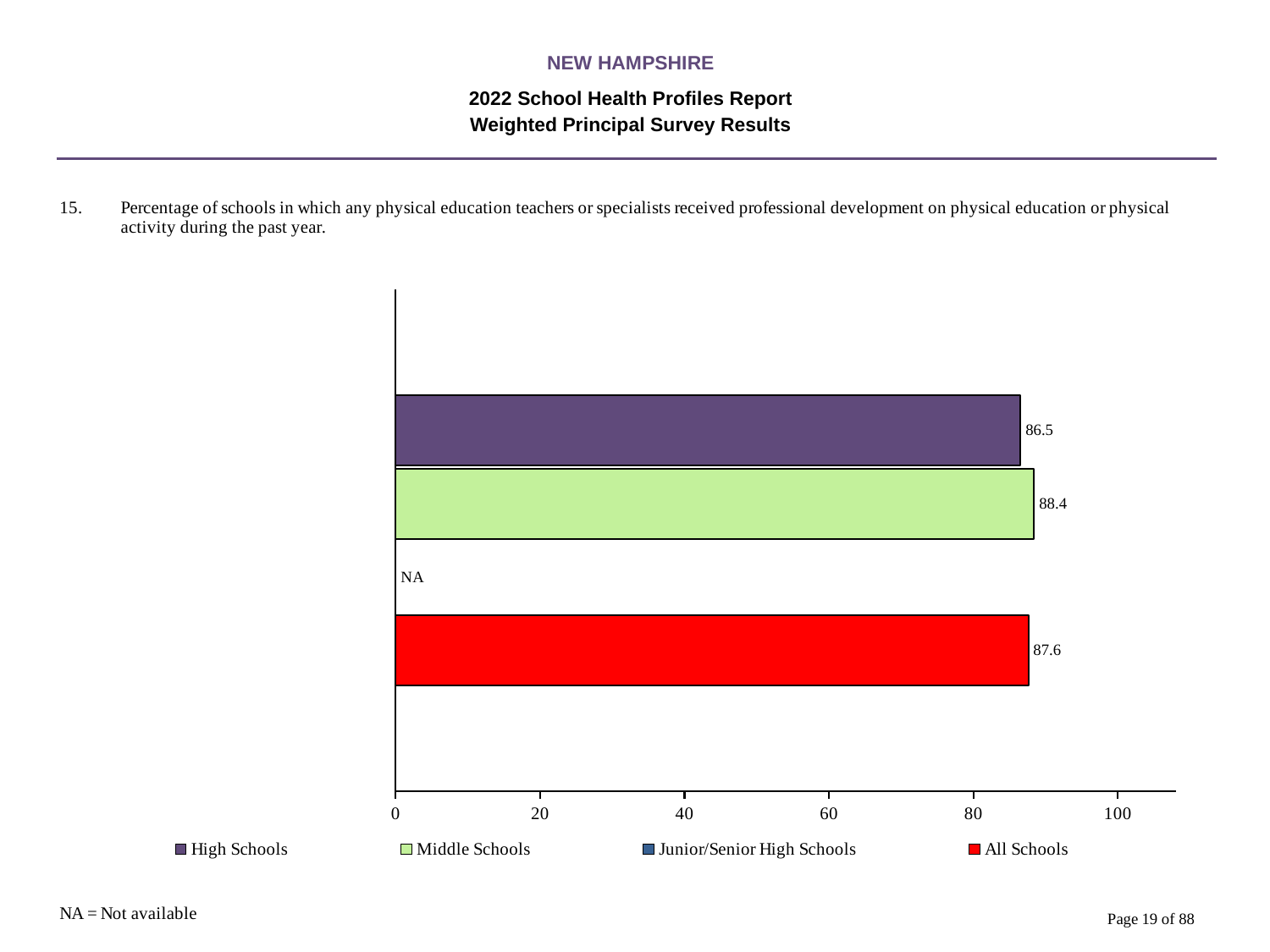
Which group has the highest value? Middle Schools What is the difference between the All Schools value and the High Schools value? 1.1 What is the value for Middle Schools? 88.4 What kind of chart is shown? bar chart Is the value for High Schools greater or less than 80? greater How many series does the legend list? 4 What is the value for All Schools? 87.6 What is the difference between the Middle Schools value and the High Schools value? 1.9 Which group with a plotted value has the lowest value? High Schools What colour is the All Schools bar? red What is shown for Junior/Senior High Schools? NA What is the value for High Schools? 86.5